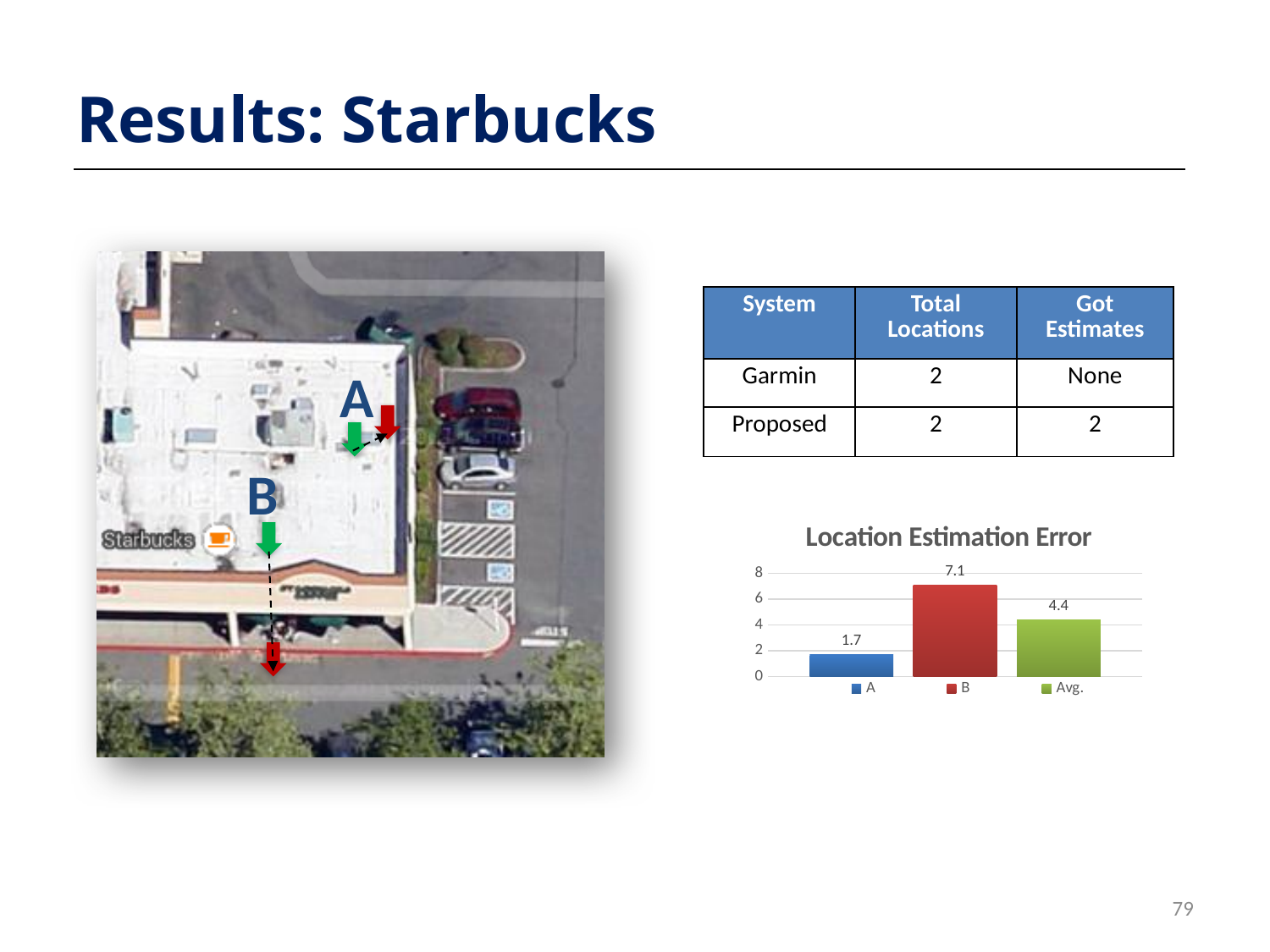
What is the title of the chart? Location Estimation Error Which is larger, the value for B or the value for Avg.? B What is the difference between the values for B and A? 5.4 What is the location estimation error for B? 7.1 Which bar has the highest value? B Is the value for B greater or less than 6? greater Which bar has the lowest value? A What is the value of the Avg. bar? 4.4 What is the location estimation error for A? 1.7 How many bars are plotted in the chart? 3 How many entries does the legend list? 3 What kind of chart is shown on the slide? bar chart